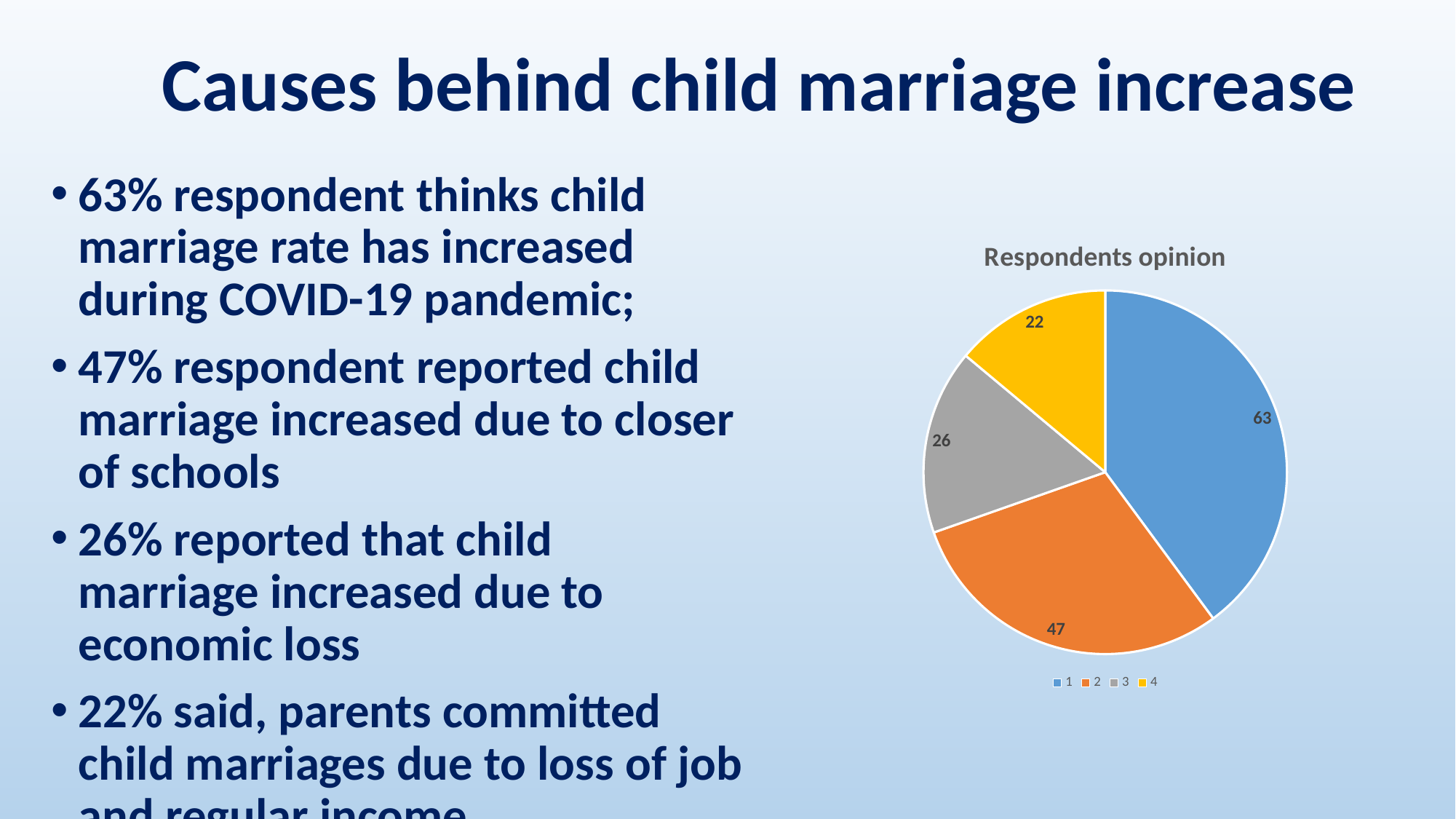
Which category has the largest slice in the Respondents opinion pie chart? 1 What is the value of slice 2 in the Respondents opinion pie chart? 47 What is the title of the chart on the slide? Respondents opinion What is the difference between the values of slice 3 and slice 4 in the Respondents opinion pie chart? 4 In the Respondents opinion pie chart, which is larger, slice 2 or slice 3? 2 Which category has the smallest slice in the Respondents opinion pie chart? 4 What is the value of slice 3 in the Respondents opinion pie chart? 26 How many slices does the Respondents opinion pie chart have? 4 What type of chart is shown on the slide? Pie chart What is the value of slice 4 in the Respondents opinion pie chart? 22 What is the value of slice 1 in the Respondents opinion pie chart? 63 What is the difference between the values of slice 1 and slice 2 in the Respondents opinion pie chart? 16